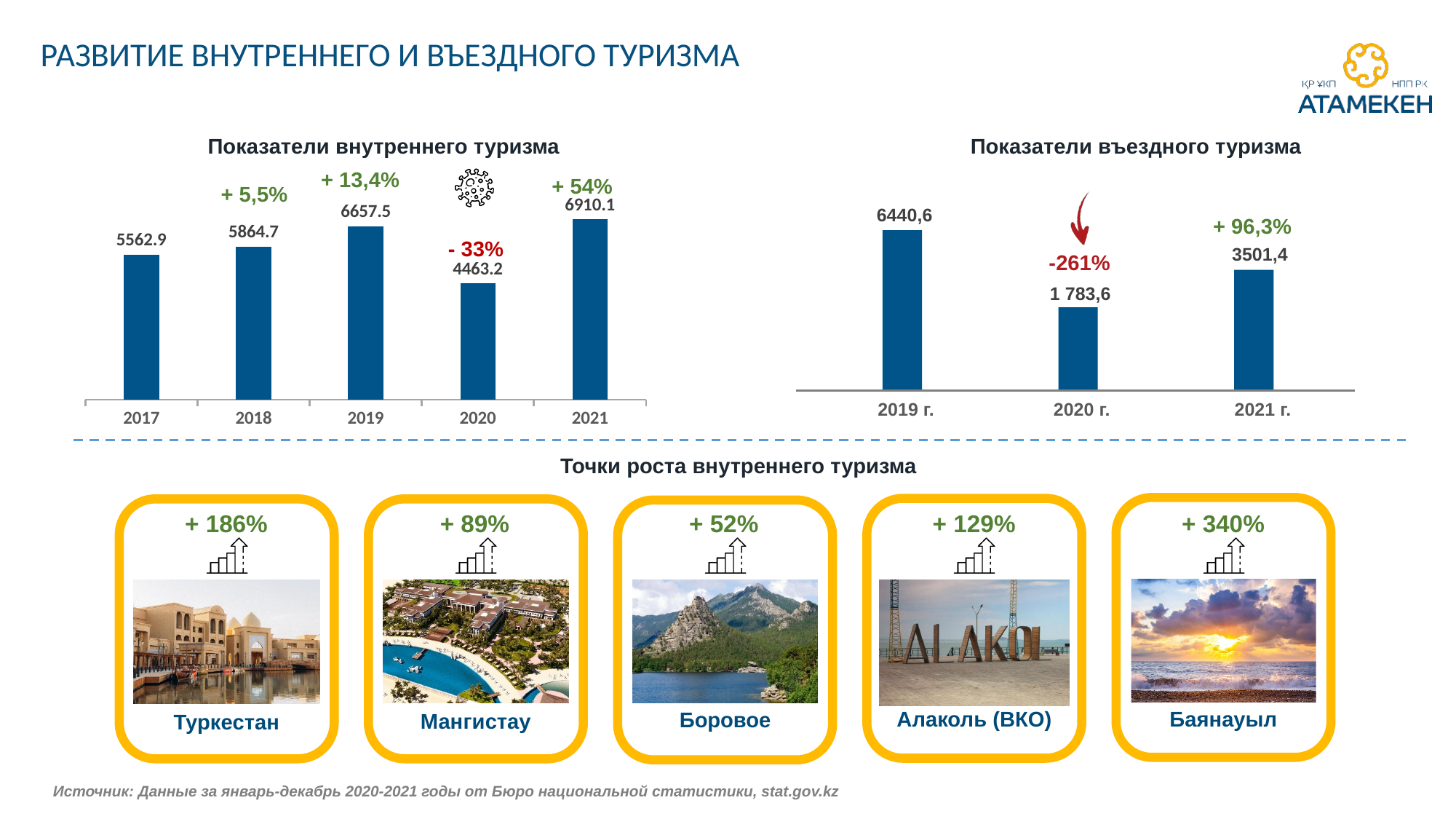
In the chart "Показатели внутреннего туризма", which year has the highest value? 2021 In the chart "Показатели въездного туризма", what is the value for 2020 г.? 1 783,6 In the chart "Показатели въездного туризма", what is the value for 2019 г.? 6440,6 In the chart "Показатели въездного туризма", which year has the highest value? 2019 г. In the chart "Показатели внутреннего туризма", what percentage change is shown above the 2020 bar? - 33% In the chart "Показатели въездного туризма", which is larger, the value for 2021 г. or the value for 2020 г.? 2021 г. In the chart "Показатели внутреннего туризма", which year has the lowest value? 2020 In the chart "Показатели внутреннего туризма", what is the value for 2017? 5562.9 What type of chart is "Показатели въездного туризма"? Bar chart In the chart "Показатели внутреннего туризма", what is the value for 2020? 4463.2 In the chart "Показатели внутреннего туризма", what is the difference between the 2021 and 2019 values? 252.6 In the chart "Показатели внутреннего туризма", how many years are shown on the x axis? 5